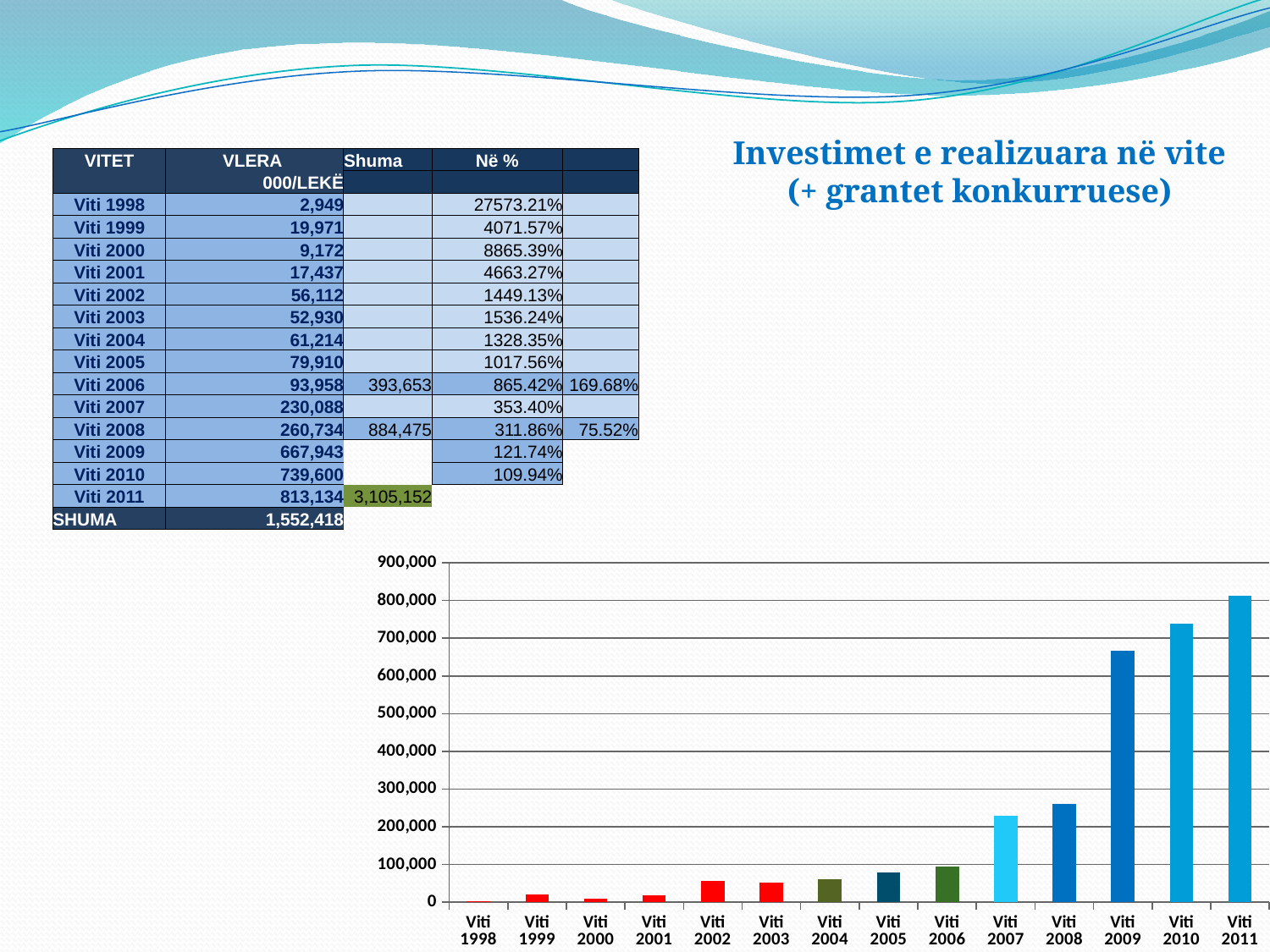
Is the bar for Viti 2005 greater or less than 100,000? less Is the bar for Viti 2010 greater or less than 700,000? greater What is the title shown on the slide above the chart? Investimet e realizuara në vite (+ grantet konkurruese) Is the bar for Viti 2008 greater or less than 300,000? less What kind of chart is shown on the slide? bar chart Do the bar values generally rise or fall from Viti 1998 to Viti 2011? rise Which bar is taller, Viti 2009 or Viti 2010? Viti 2010 Which year has the tallest bar in the chart? Viti 2011 Which bar is taller, Viti 2007 or Viti 2008? Viti 2008 How many years (categories) are plotted on the x axis of the chart? 14